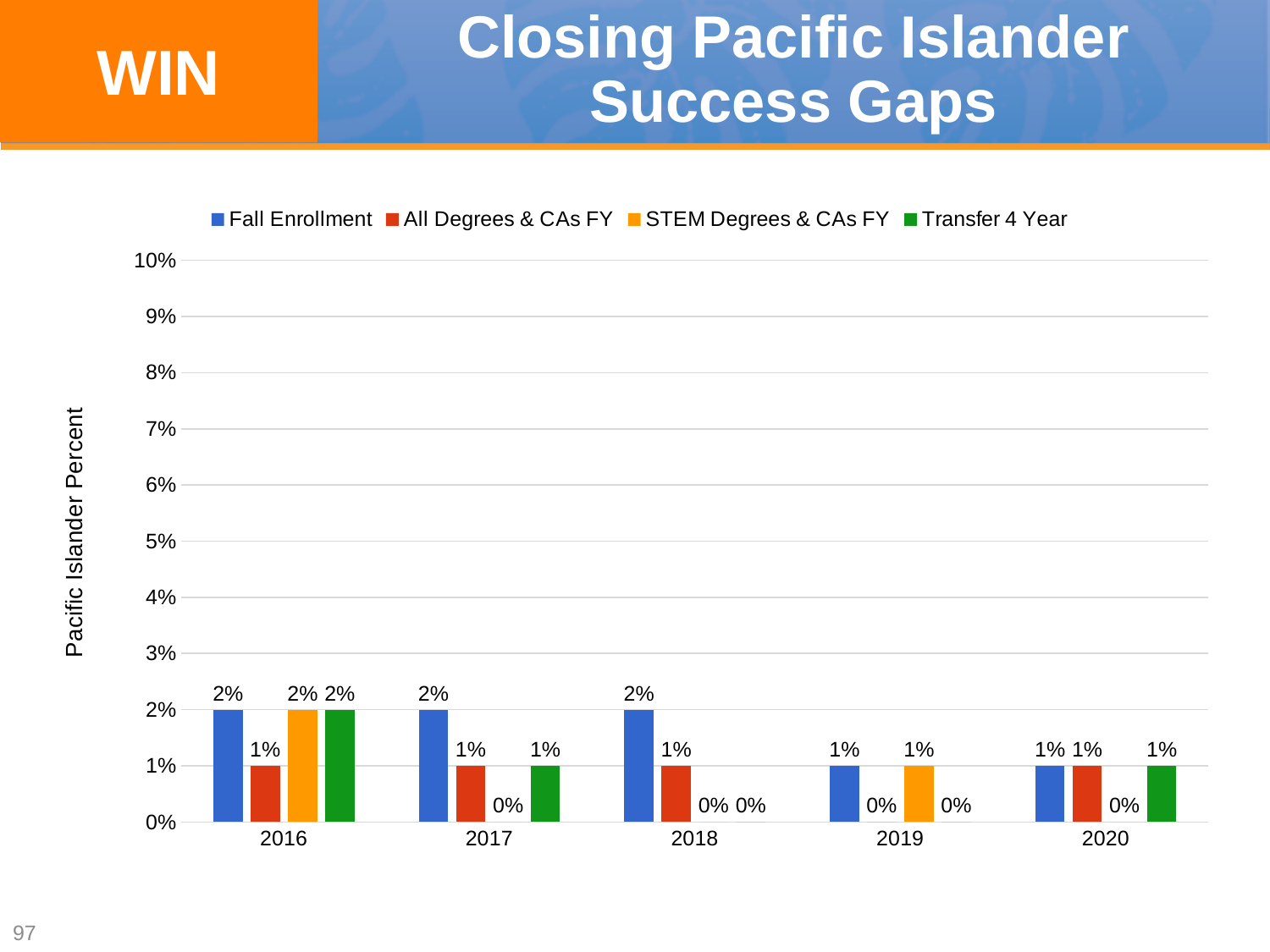
What is the All Degrees & CAs FY value for 2019? 0% How many years are shown on the x axis? 5 What is the Transfer 4 Year value for 2018? 0% What kind of chart is shown on the slide? Bar chart Does the Fall Enrollment value rise or fall from 2016 to 2020? Fall What is the Fall Enrollment value for 2016? 2% What is the STEM Degrees & CAs FY value for 2017? 0% What is the Fall Enrollment value for 2020? 1% How many series does the legend list? 4 What is the difference between the Fall Enrollment value and the All Degrees & CAs FY value in 2016? 1% In 2018, which is larger: Fall Enrollment or All Degrees & CAs FY? Fall Enrollment What is the label on the vertical axis? Pacific Islander Percent